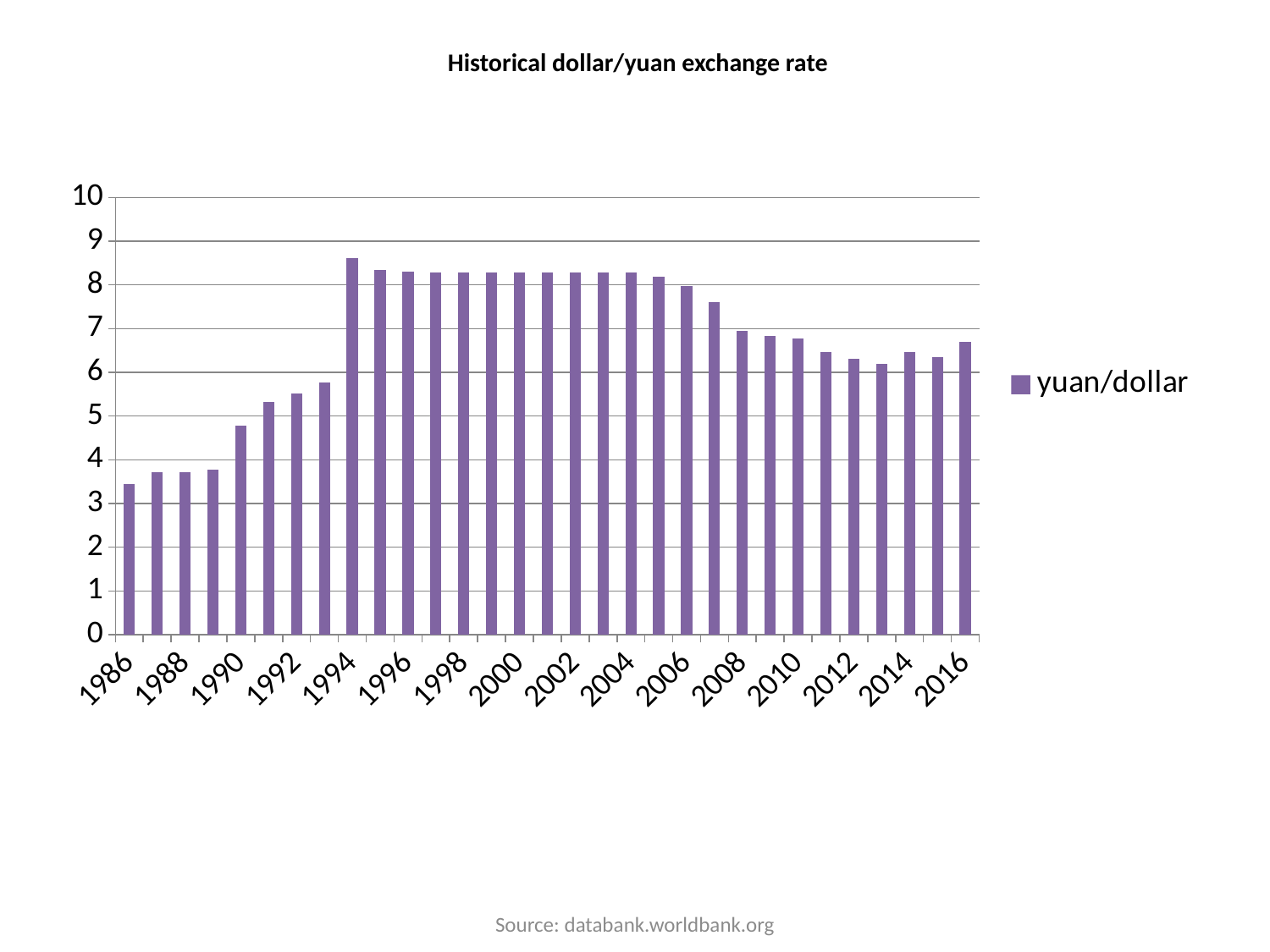
How many bars (years) are plotted in the chart? 31 What is the title of the chart? Historical dollar/yuan exchange rate What is the name of the series shown in the legend? yuan/dollar Which year has the highest yuan/dollar value? 1994 Is the value for 2016 greater or less than 6? greater Is the value for 1994 greater or less than 8? greater What kind of chart is shown on the slide? bar chart How many series does the legend list? 1 Is the value for 1986 greater or less than 4? less Which is larger, the value for 1990 or the value for 1986? 1990 Do the values rise or fall from 1986 to 1994? rise Which year has the lowest yuan/dollar value? 1986